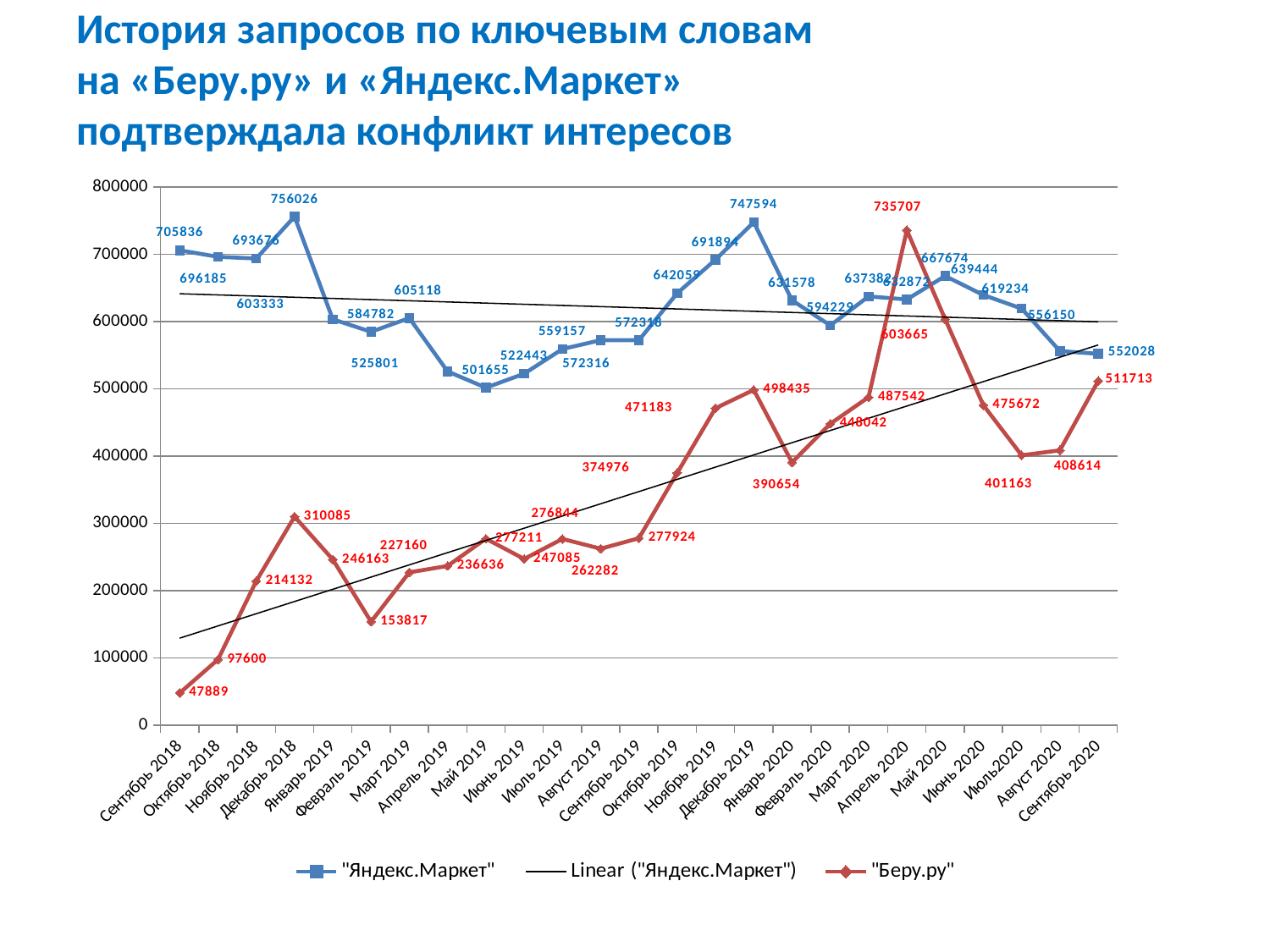
How many entries does the chart legend list? 3 Does the "Беру.ру" series generally rise or fall from Сентябрь 2018 to Сентябрь 2020? rise In which month is the "Беру.ру" series at its lowest value? Сентябрь 2018 What kind of chart is shown on the slide? line chart How many months are plotted along the x axis? 25 In which month does the "Яндекс.Маркет" series reach its highest value? Декабрь 2018 What is the value of "Яндекс.Маркет" in Сентябрь 2020? 552028 In which month is the "Яндекс.Маркет" series at its lowest value? Май 2019 What is the difference between "Яндекс.Маркет" and "Беру.ру" in Декабрь 2018? 445941 In Апрель 2020, which series has the higher value, "Яндекс.Маркет" or "Беру.ру"? "Беру.ру" What is the value of "Беру.ру" in Апрель 2020? 735707 In which month does the "Беру.ру" series reach its highest value? Апрель 2020